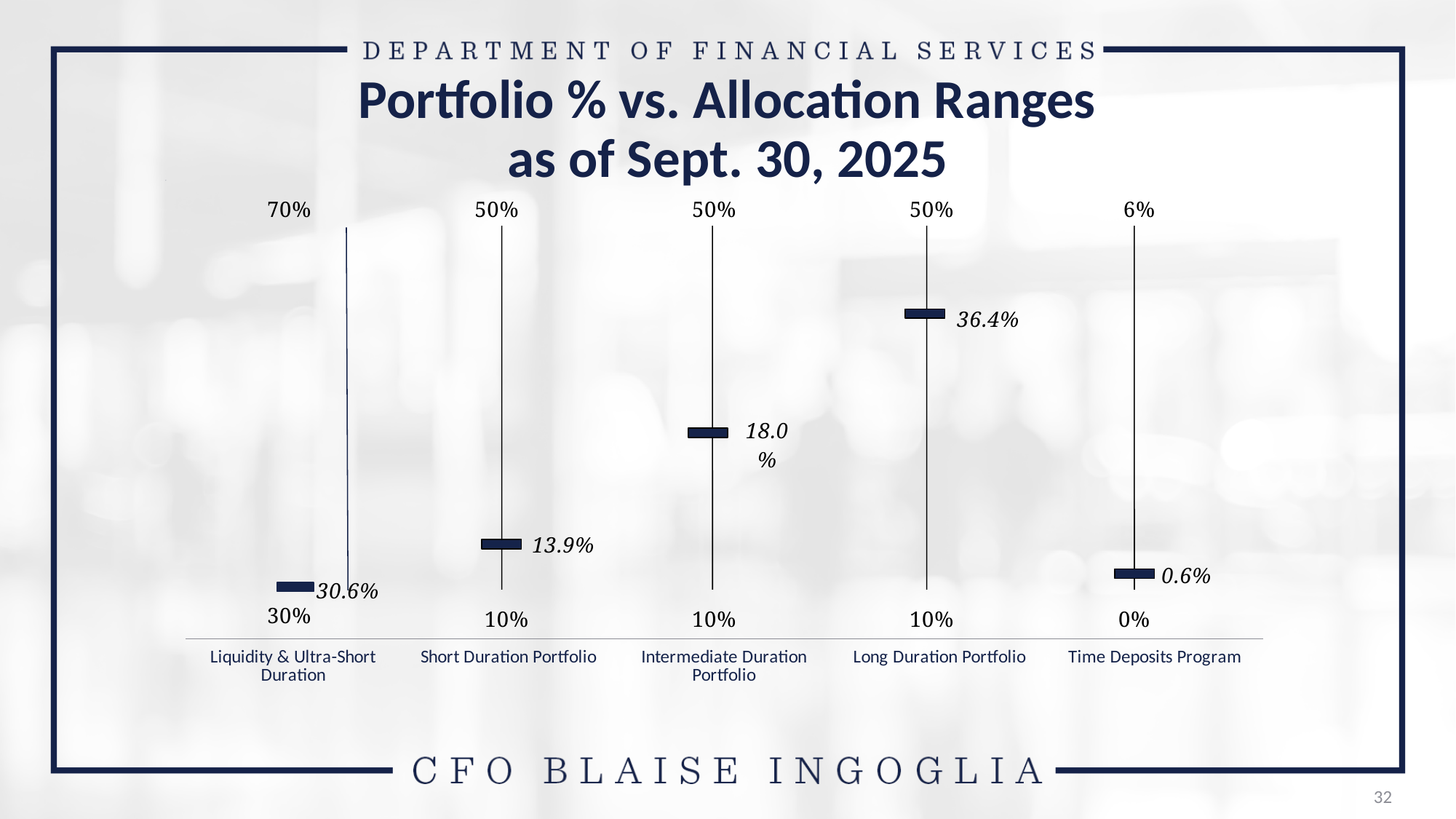
Which category has the highest portfolio percentage? Long Duration Portfolio How many categories are shown on the chart? 5 What is the difference between the portfolio percentages of the Long Duration Portfolio and the Intermediate Duration Portfolio? 18.4% What is the portfolio percentage for Liquidity & Ultra-Short Duration? 30.6% What is the portfolio percentage for the Long Duration Portfolio? 36.4% What is the upper bound of the allocation range for the Time Deposits Program? 6% What is the portfolio percentage for the Short Duration Portfolio? 13.9% What is the upper bound of the allocation range for Liquidity & Ultra-Short Duration? 70% Which has a larger portfolio percentage, the Short Duration Portfolio or the Intermediate Duration Portfolio? Intermediate Duration Portfolio What is the title of the chart? Portfolio % vs. Allocation Ranges as of Sept. 30, 2025 What is the portfolio percentage for the Time Deposits Program? 0.6% Which category has the lowest portfolio percentage? Time Deposits Program